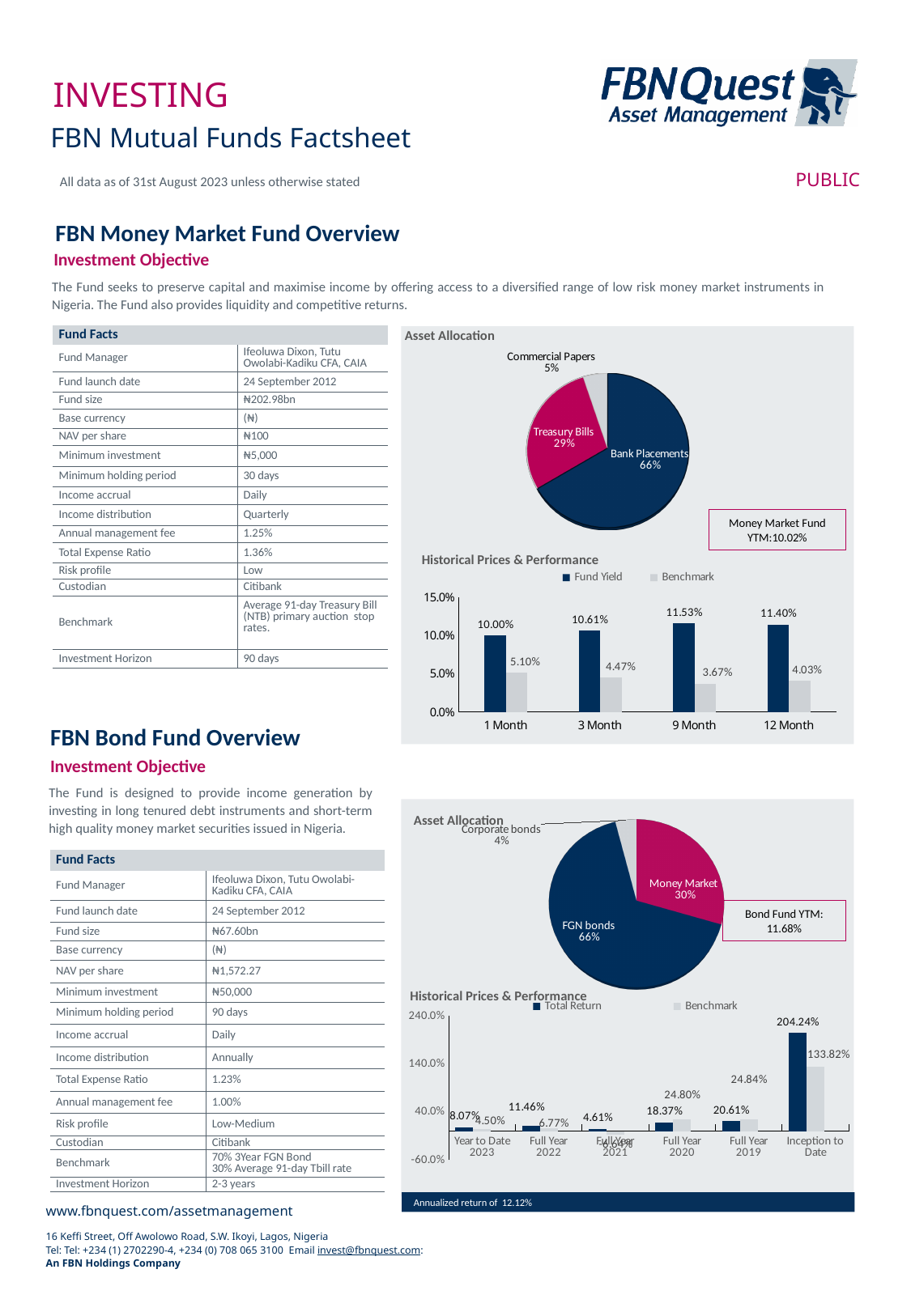
In the FBN Money Market Fund Historical Prices & Performance chart, what is the Fund Yield for 9 Month? 11.53% In the FBN Bond Fund Historical Prices & Performance chart, what is the Total Return for Full Year 2019? 20.61% In the FBN Bond Fund Asset Allocation pie chart, which category has the largest share? FGN bonds In the FBN Money Market Fund Asset Allocation pie chart, which category has the smallest share? Commercial Papers What kind of chart is the FBN Bond Fund Historical Prices & Performance chart? Bar chart In the FBN Money Market Fund Asset Allocation pie chart, what share is Bank Placements? 66% In the FBN Bond Fund Asset Allocation pie chart, what share is Money Market? 30% How many series does the legend of the FBN Money Market Fund Historical Prices & Performance chart list? 2 In the FBN Money Market Fund Historical Prices & Performance chart, what is the Benchmark value for 1 Month? 5.10% In the FBN Money Market Fund Historical Prices & Performance chart, which period has the lowest Benchmark value? 9 Month In the FBN Money Market Fund Historical Prices & Performance chart, what is the difference between the Fund Yield and the Benchmark for 12 Month? 7.37% In the FBN Bond Fund Historical Prices & Performance chart, which is larger for Full Year 2020, the Total Return or the Benchmark? Benchmark